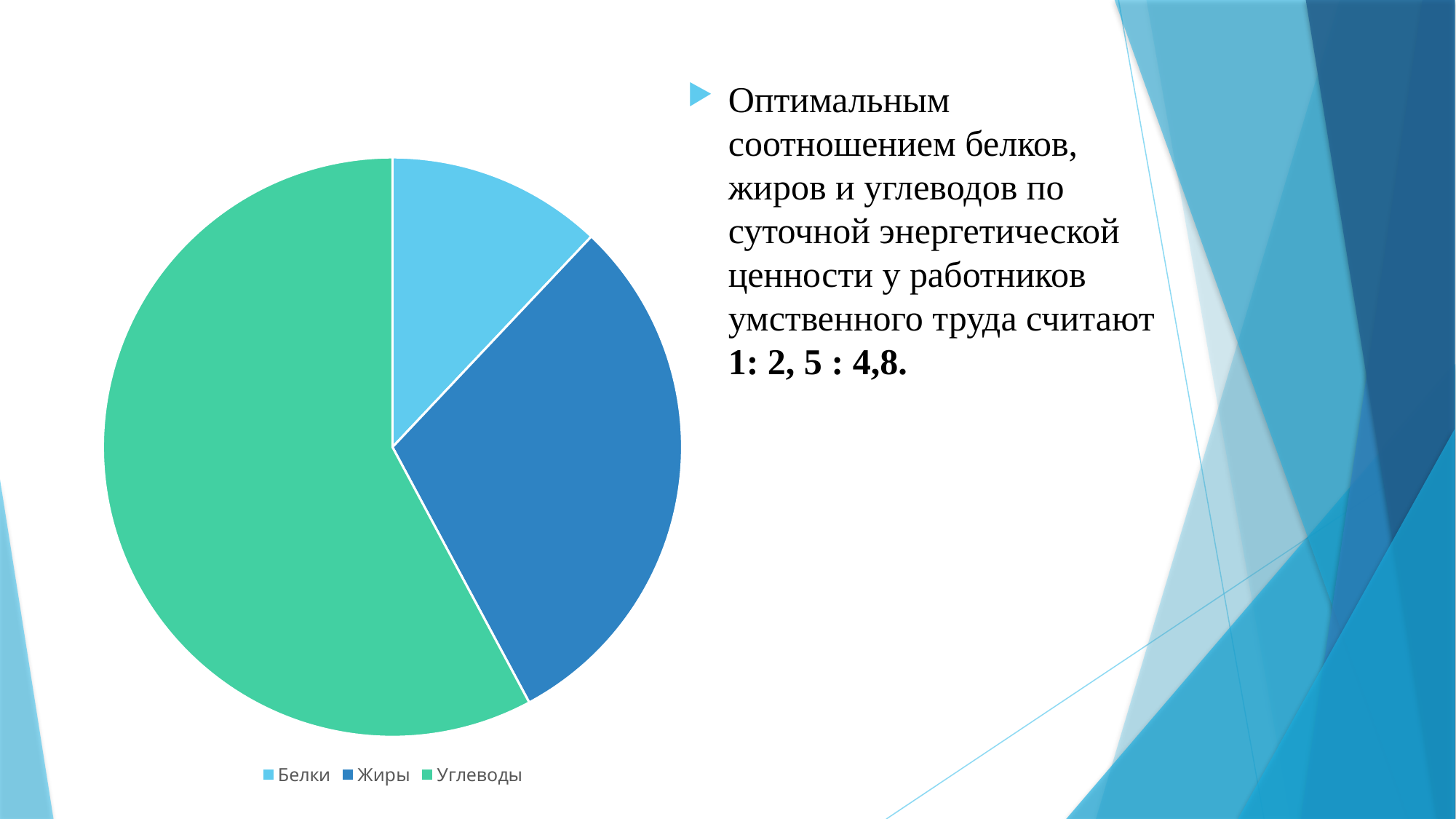
Which slice is larger in the pie chart, Жиры or Белки? Жиры How many entries does the legend of the pie chart list? 3 Which category has the smallest slice in the pie chart? Белки What colour is the Углеводы slice in the pie chart? green How many slices does the pie chart have? 3 Does the Углеводы slice take up more or less than half of the pie chart? more What kind of chart is shown on the slide? pie chart Which slice is larger in the pie chart, Углеводы or Жиры? Углеводы Which category has the largest slice in the pie chart? Углеводы Which legend entry is shown in light blue in the pie chart? Белки